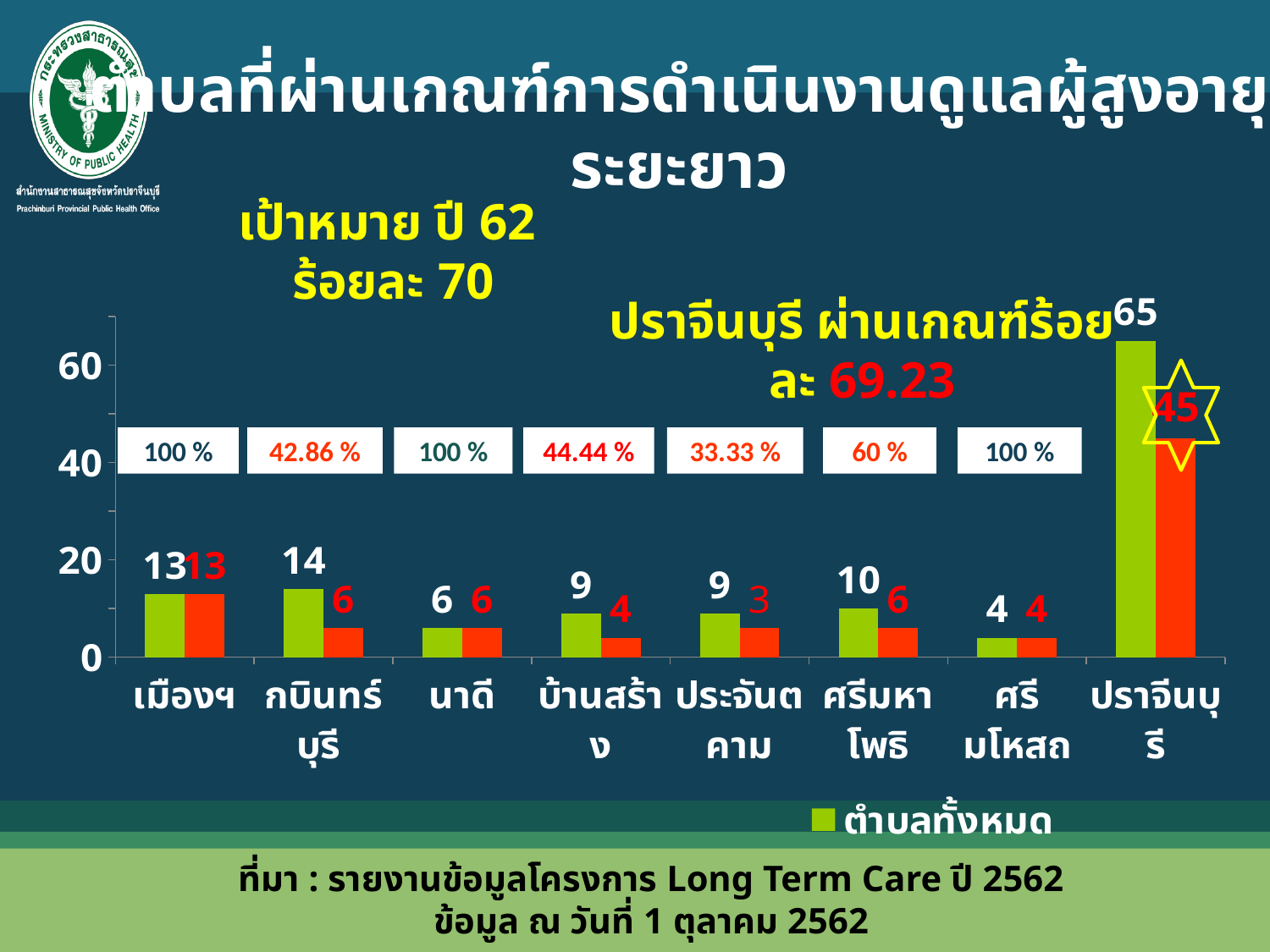
What is the value of the green bar (ตำบลทั้งหมด) for กบินทร์บุรี? 14 What is the value of the red bar for ศรีมหาโพธิ? 6 What percentage label is shown above the bars for ประจันตคาม? 33.33 % Which category has the lowest value for the green bars (ตำบลทั้งหมด)? ศรีมโหสถ What is the difference between the green bar and the red bar for ปราจีนบุรี? 20 How many categories are shown on the x axis? 8 What is the difference between the green bar and the red bar for บ้านสร้าง? 5 Which category has the highest value for the red bars? ปราจีนบุรี Which is larger for กบินทร์บุรี: the green bar or the red bar? the green bar What is the value of the red bar for ประจันตคาม? 3 What is the value of the green bar (ตำบลทั้งหมด) for ปราจีนบุรี? 65 What type of chart is shown on the slide? bar chart